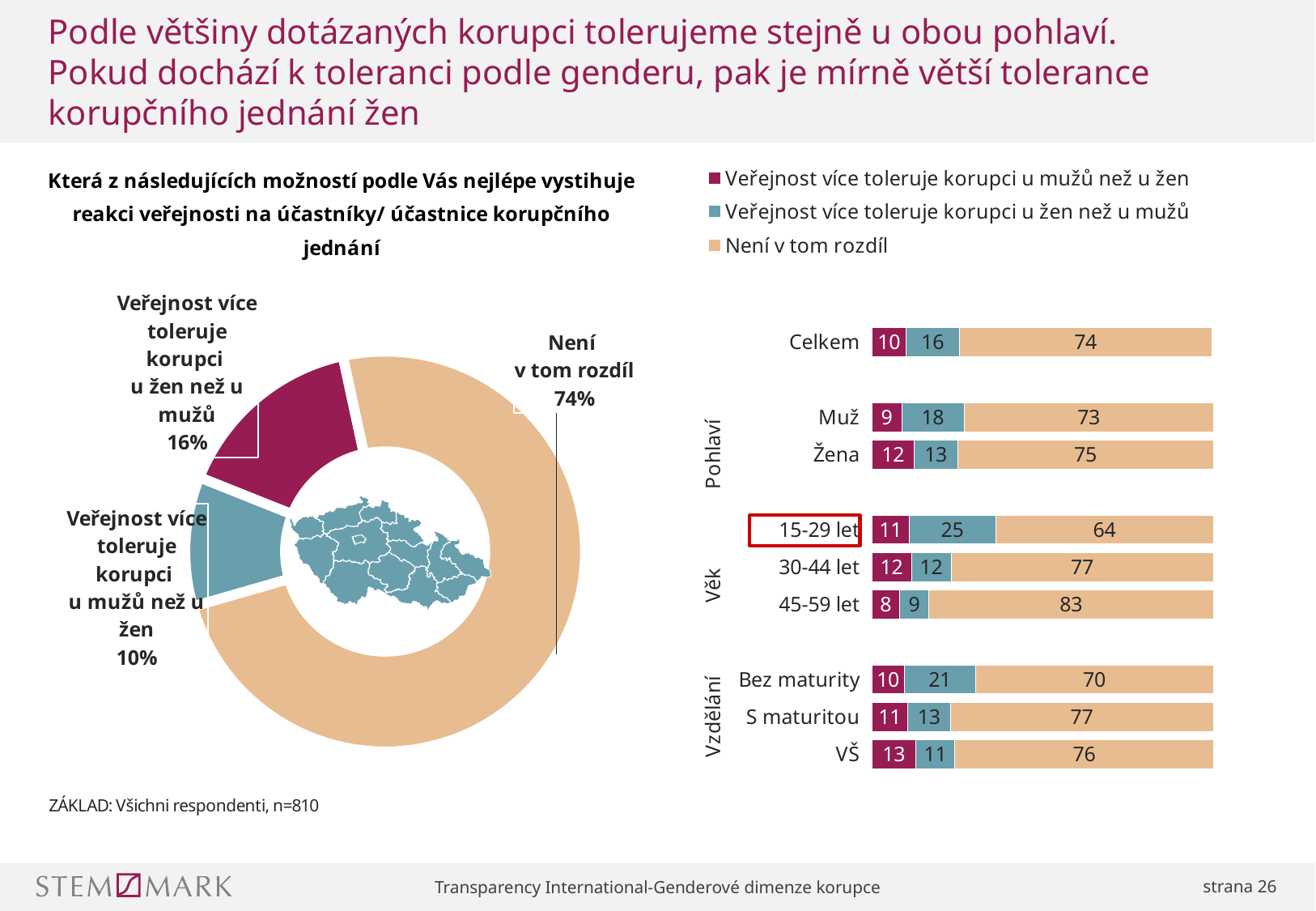
In the pie chart on the left, what share of respondents answered "Není v tom rozdíl"? 74% How many categories (rows) does the bar chart on the right show? 9 In the bar chart on the right, which category has the lowest value for "Není v tom rozdíl"? 15-29 let In the bar chart on the right, what is the value of "Veřejnost více toleruje korupci u žen než u mužů" for the 15-29 let group? 25 In the bar chart on the right, which category has the highest value for "Není v tom rozdíl"? 45-59 let What kind of chart is shown on the left of the slide? Pie (donut) chart In the pie chart on the left, which answer has the smallest share? Veřejnost více toleruje korupci u mužů než u žen In the bar chart on the right, what is the difference between the "Není v tom rozdíl" values for Žena and Muž? 2 How many series does the legend of the bar chart on the right list? 3 In the pie chart on the left, what share of respondents answered "Veřejnost více toleruje korupci u mužů než u žen"? 10% In the bar chart on the right, what is the value of "Není v tom rozdíl" for the 45-59 let group? 83 In the bar chart on the right, which is larger: the "Veřejnost více toleruje korupci u žen než u mužů" value for Bez maturity or for VŠ? Bez maturity